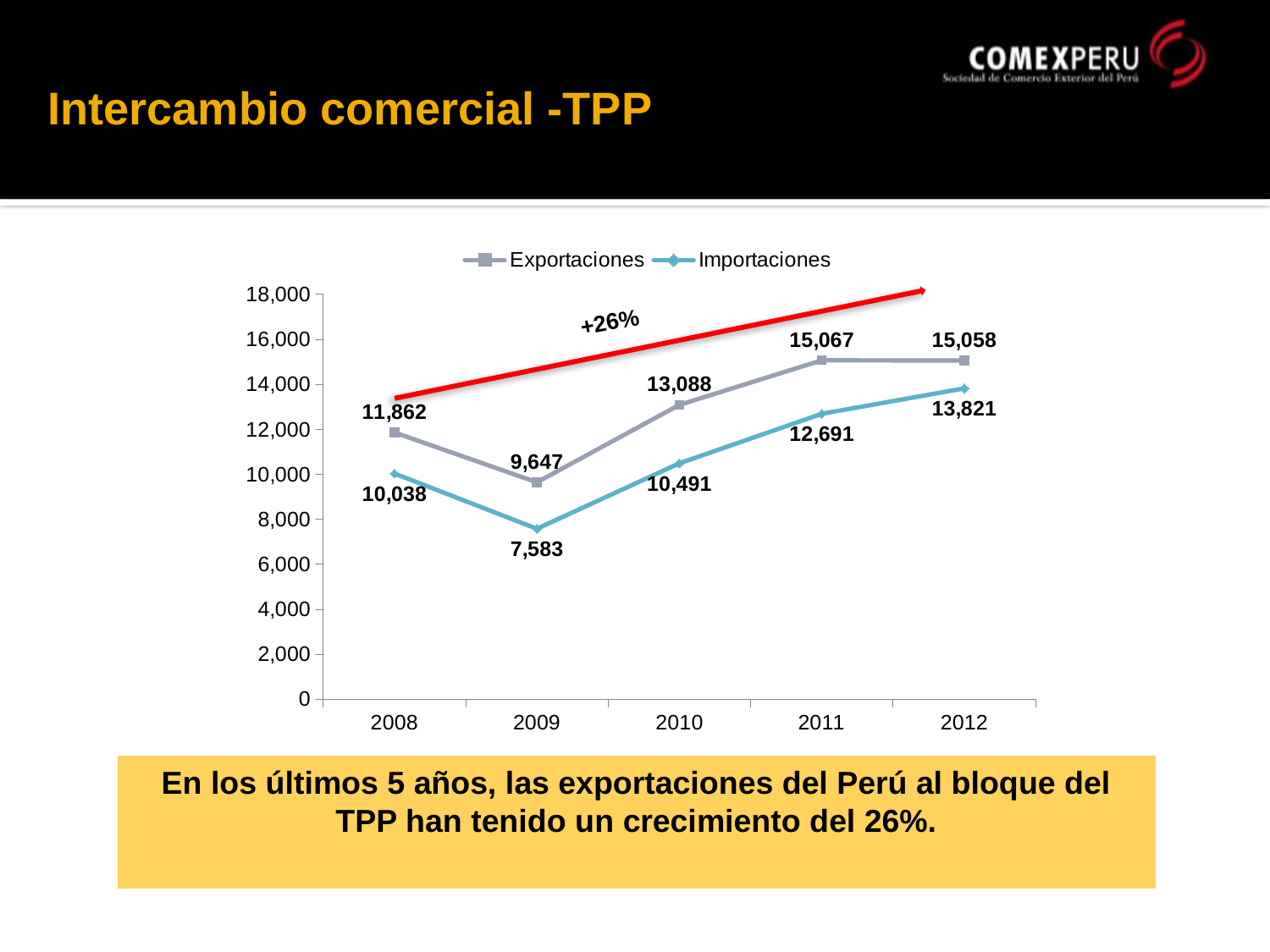
In which year is Importaciones highest? 2012 What is the value of Importaciones in 2012? 13,821 How many years are shown on the x axis? 5 What is the difference between Exportaciones in 2011 and Exportaciones in 2009? 5,420 Which is larger in 2011, Exportaciones or Importaciones? Exportaciones How many series does the legend list? 2 In which year is Exportaciones lowest? 2009 What is the value of Importaciones in 2009? 7,583 What growth percentage is annotated next to the red arrow on the chart? +26% What is the value of Exportaciones in 2010? 13,088 What kind of chart is shown on the slide? Line chart What is the difference between Exportaciones and Importaciones in 2008? 1,824